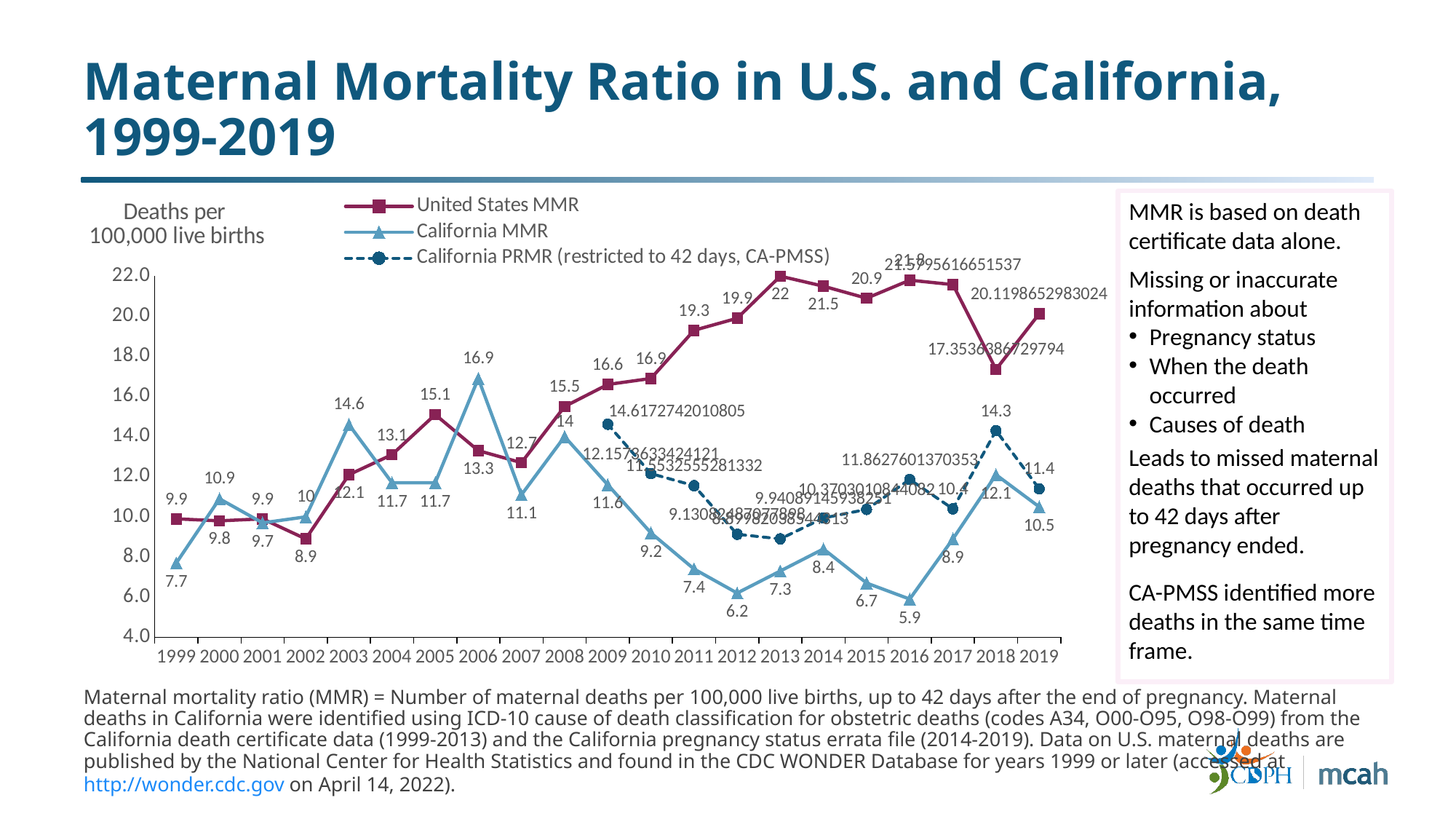
In which year was the California MMR lowest? 2016 What is the difference between the United States MMR in 2013 and in 1999? 12.1 What was the California MMR in 2016? 5.9 What was the California PRMR (restricted to 42 days, CA-PMSS) in 2018? 14.3 What was the United States MMR in 2013? 22 How many years are shown on the x axis of the chart? 21 How many series does the chart legend list? 3 In which year was the United States MMR highest? 2013 In 2006, which was higher: the United States MMR or the California MMR? California MMR What was the California MMR in 2006? 16.9 Is the United States MMR in 2011 greater or less than 18.0? greater What kind of chart is shown on the slide? line chart